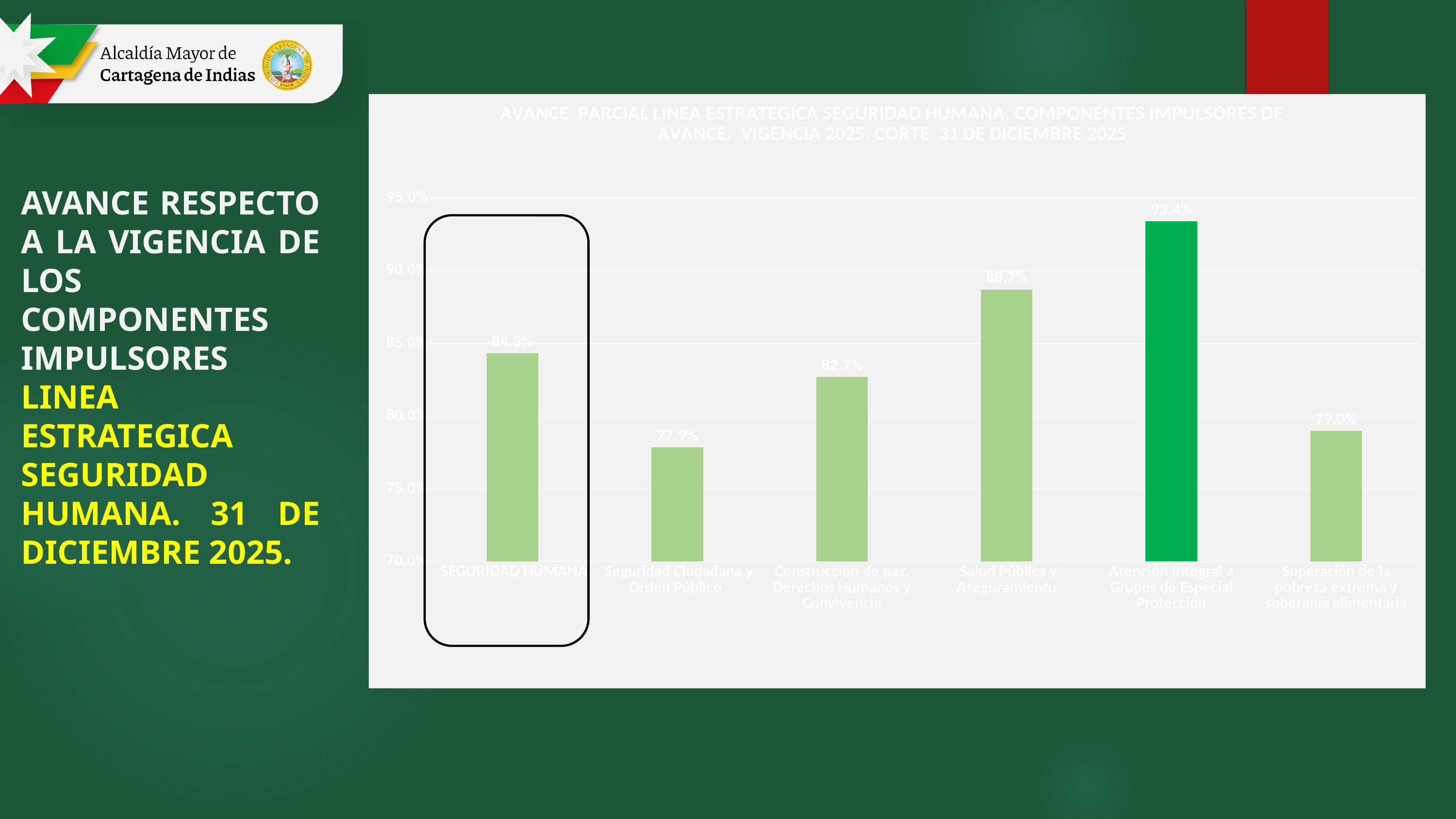
What is the value for Atención Integral a Grupos de Especial Protección? 93.4% Which category has the highest value? Atención Integral a Grupos de Especial Protección What is the value for Salud Pública y Aseguramiento? 88.7% What is the value for SEGURIDAD HUMANA? 84.3% Which bar is drawn in a darker green than the others? Atención Integral a Grupos de Especial Protección Is the value for Superación de la pobreza extrema y soberanía alimentaria greater or less than 80.0%? less Which category has the lowest value? Seguridad Ciudadana y Orden Público What is the difference between the values for Atención Integral a Grupos de Especial Protección and Salud Pública y Aseguramiento? 4.7% Which is larger, the value for Construccion de paz, Derechos Humanos y Convivencia or the value for Superación de la pobreza extrema y soberanía alimentaria? Construccion de paz, Derechos Humanos y Convivencia What is the value for Seguridad Ciudadana y Orden Público? 77.9% What kind of chart is shown on the slide? Bar chart How many categories are shown in the chart? 6